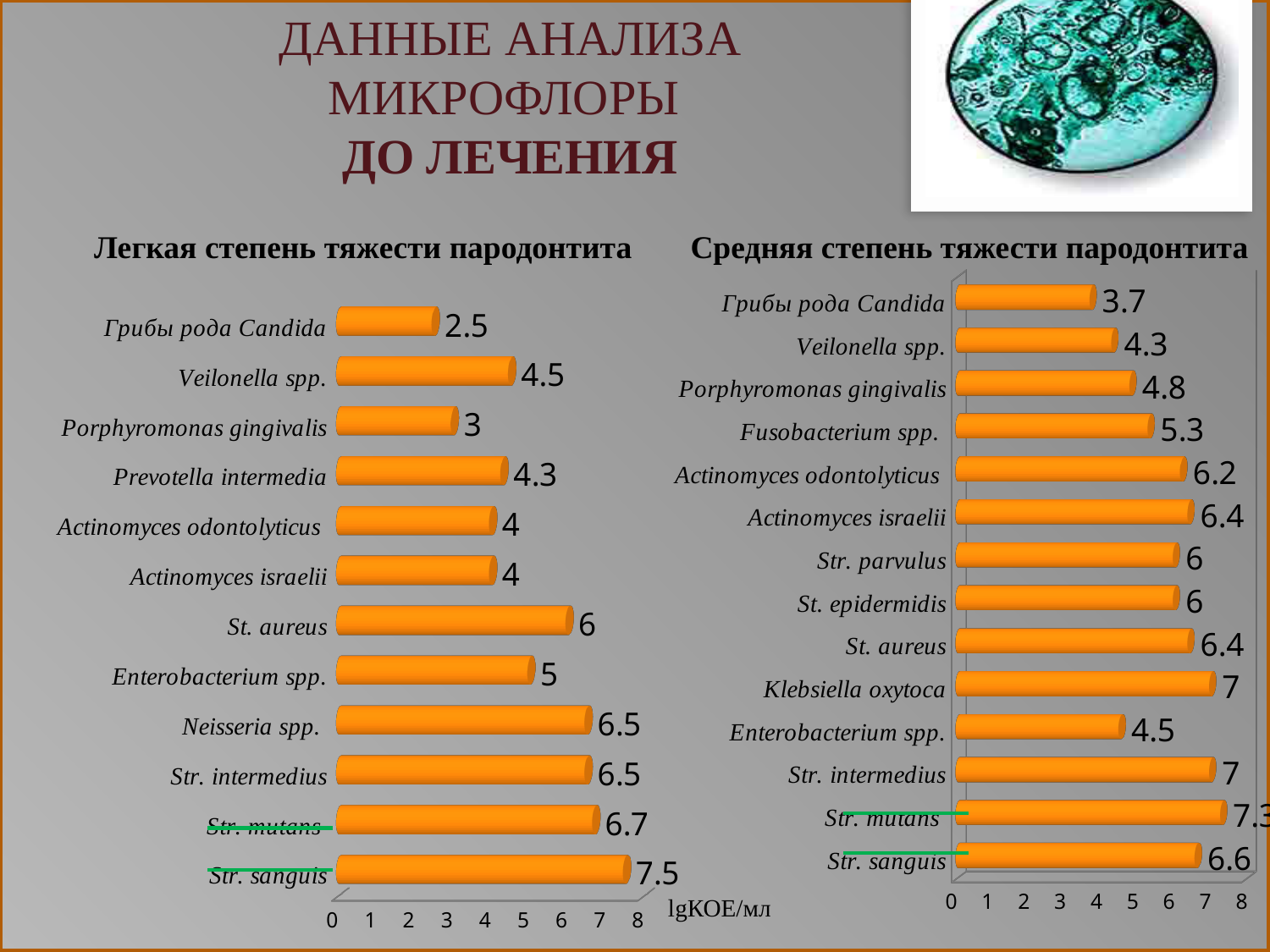
In the chart titled "Средняя степень тяжести пародонтита", what is the value for Klebsiella oxytoca? 7 In the chart titled "Средняя степень тяжести пародонтита", what is the value for Fusobacterium spp.? 5.3 In the chart titled "Средняя степень тяжести пародонтита", which category has the lowest value? Грибы рода Candida In the chart titled "Легкая степень тяжести пародонтита", what is the value for Str. sanguis? 7.5 In the chart titled "Средняя степень тяжести пародонтита", which is larger: the value for Actinomyces israelii or the value for Enterobacterium spp.? Actinomyces israelii In the chart titled "Легкая степень тяжести пародонтита", which category has the lowest value? Грибы рода Candida In the chart titled "Легкая степень тяжести пародонтита", what is the value for Грибы рода Candida? 2.5 How many categories are shown in the chart titled "Легкая степень тяжести пародонтита"? 12 How many categories are shown in the chart titled "Средняя степень тяжести пародонтита"? 14 In the chart titled "Легкая степень тяжести пародонтита", what is the difference between the values for Str. sanguis and Грибы рода Candida? 5 In the chart titled "Легкая степень тяжести пародонтита", which category has the highest value? Str. sanguis What type of chart is the chart titled "Легкая степень тяжести пародонтита"? Bar chart